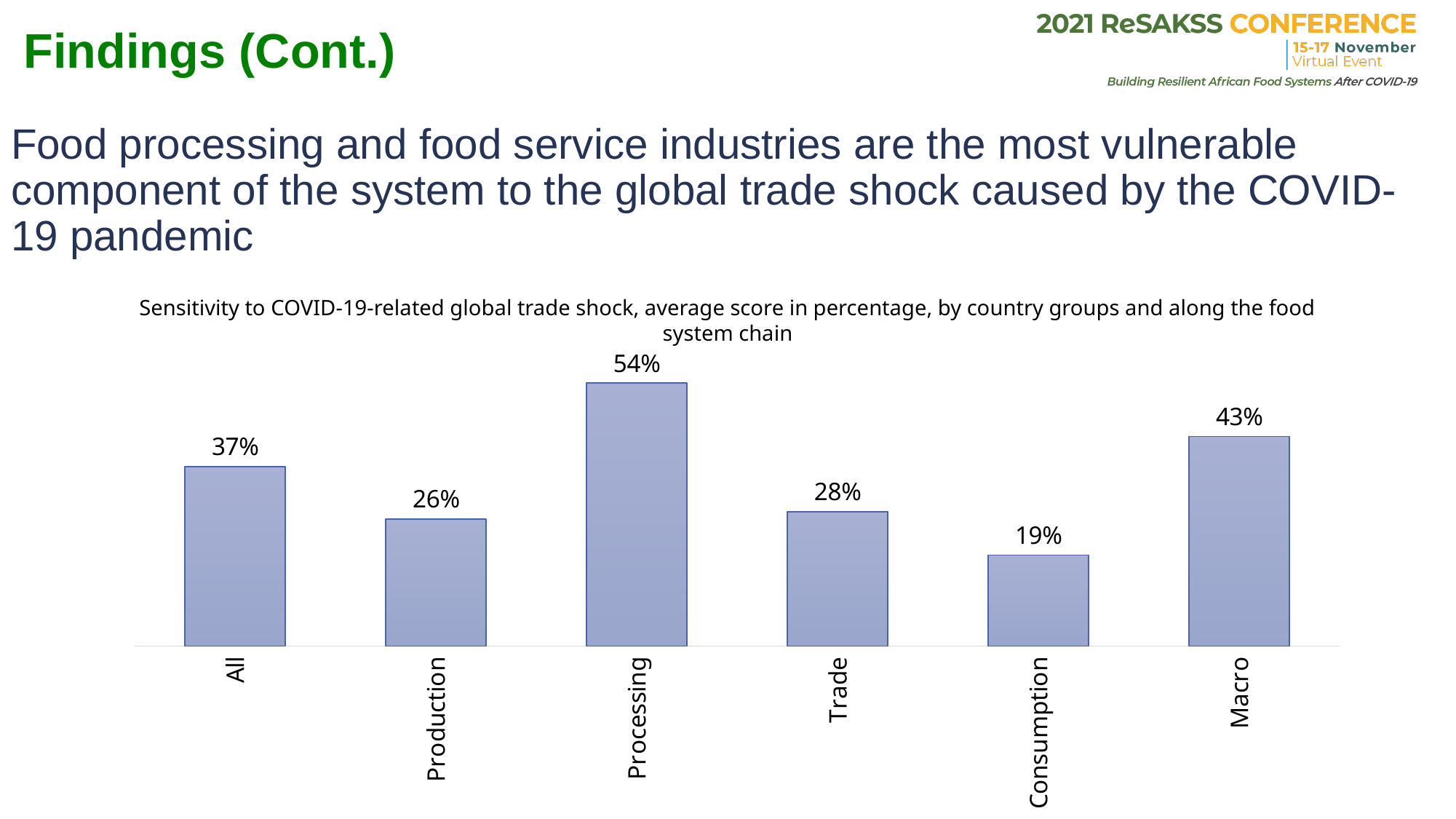
What is the difference between the values for Macro and Trade? 15% What is the title of the chart? Sensitivity to COVID-19-related global trade shock, average score in percentage, by country groups and along the food system chain What is the value for Processing? 54% How many categories are shown on the x axis? 6 Which category has the lowest value? Consumption What is the value for All? 37% What is the value for Macro? 43% Which is larger, the value for Trade or the value for Production? Trade What is the difference between the values for Processing and Production? 28% What kind of chart is shown on the slide? Bar chart Which category has the highest value? Processing What is the value for Consumption? 19%